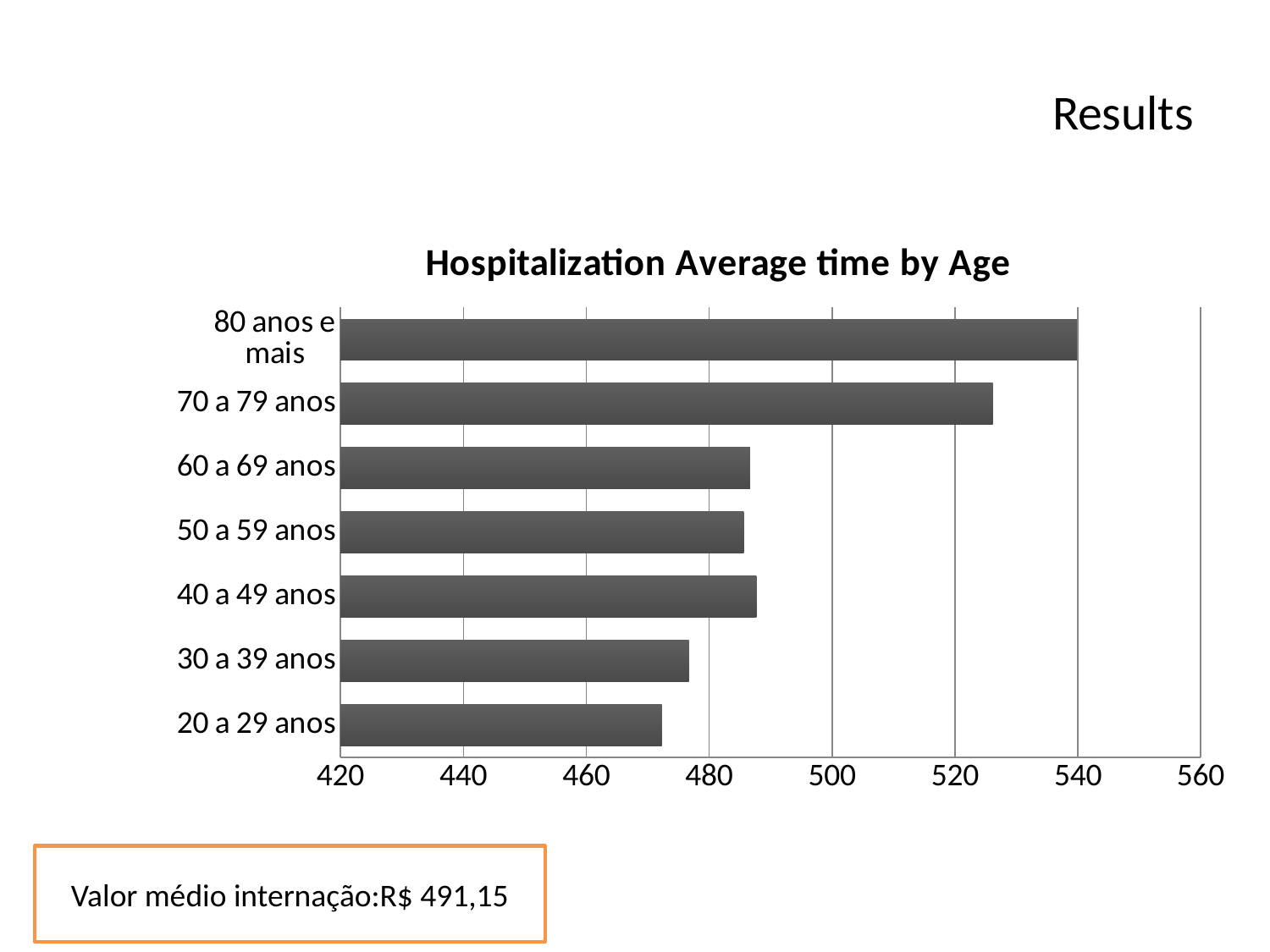
What type of chart is shown on the slide? bar chart Is the value for 20 a 29 anos greater or less than 480? less Is the value for 80 anos e mais greater or less than 520? greater How many age groups are plotted in the chart? 7 Is the value for 50 a 59 anos greater or less than 500? less Which has a higher value: 40 a 49 anos or 30 a 39 anos? 40 a 49 anos Which age group has the lowest hospitalization average time? 20 a 29 anos What is the title of the chart? Hospitalization Average time by Age Which has a higher value: 70 a 79 anos or 60 a 69 anos? 70 a 79 anos Which age group has the highest hospitalization average time? 80 anos e mais